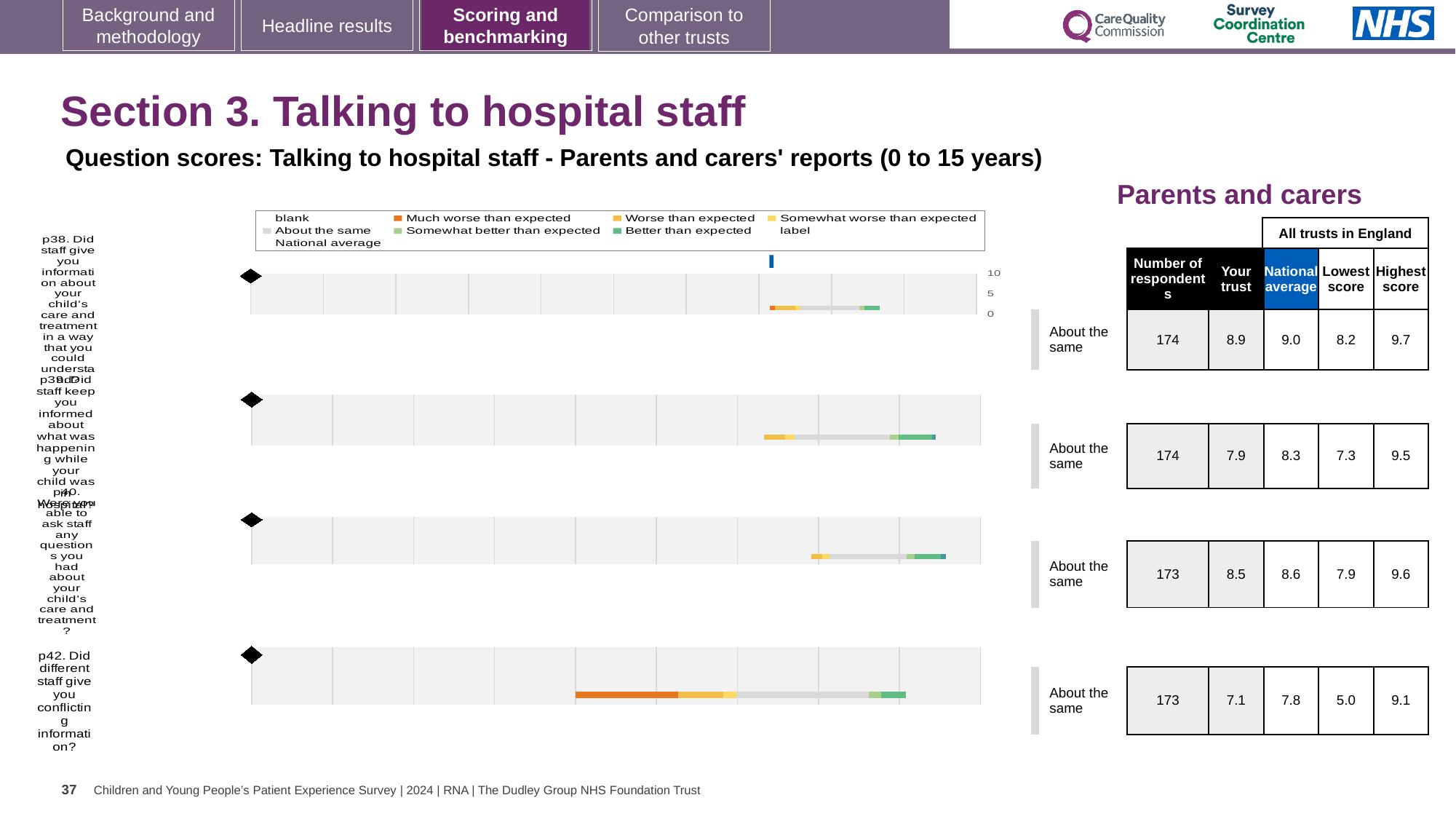
What is the Lowest score across all trusts in England for p42 (Did different staff give you conflicting information)? 5.0 What is the Highest score across all trusts in England for p40 (Were you able to ask staff any questions you had about your child's care and treatment)? 9.6 What kind of chart is used to show the question scores on this slide? bar chart How many questions (p38, p39, p40, p42) are plotted on the slide? 4 What is the difference between the National average and the 'Your trust' score for p42? 0.7 Which question has the highest 'Your trust' score? p38 Which question has the lowest 'Your trust' score? p42 What benchmark category is shown for all four questions on this slide? About the same What is the 'Your trust' score for p38 (Did staff give you information about your child's care and treatment in a way that you could understand)? 8.9 How many respondents answered p42? 173 What is the National average score for p39 (Did staff keep you informed about what was happening while your child was in hospital)? 8.3 For p39, which is larger: the 'Your trust' score or the National average? National average